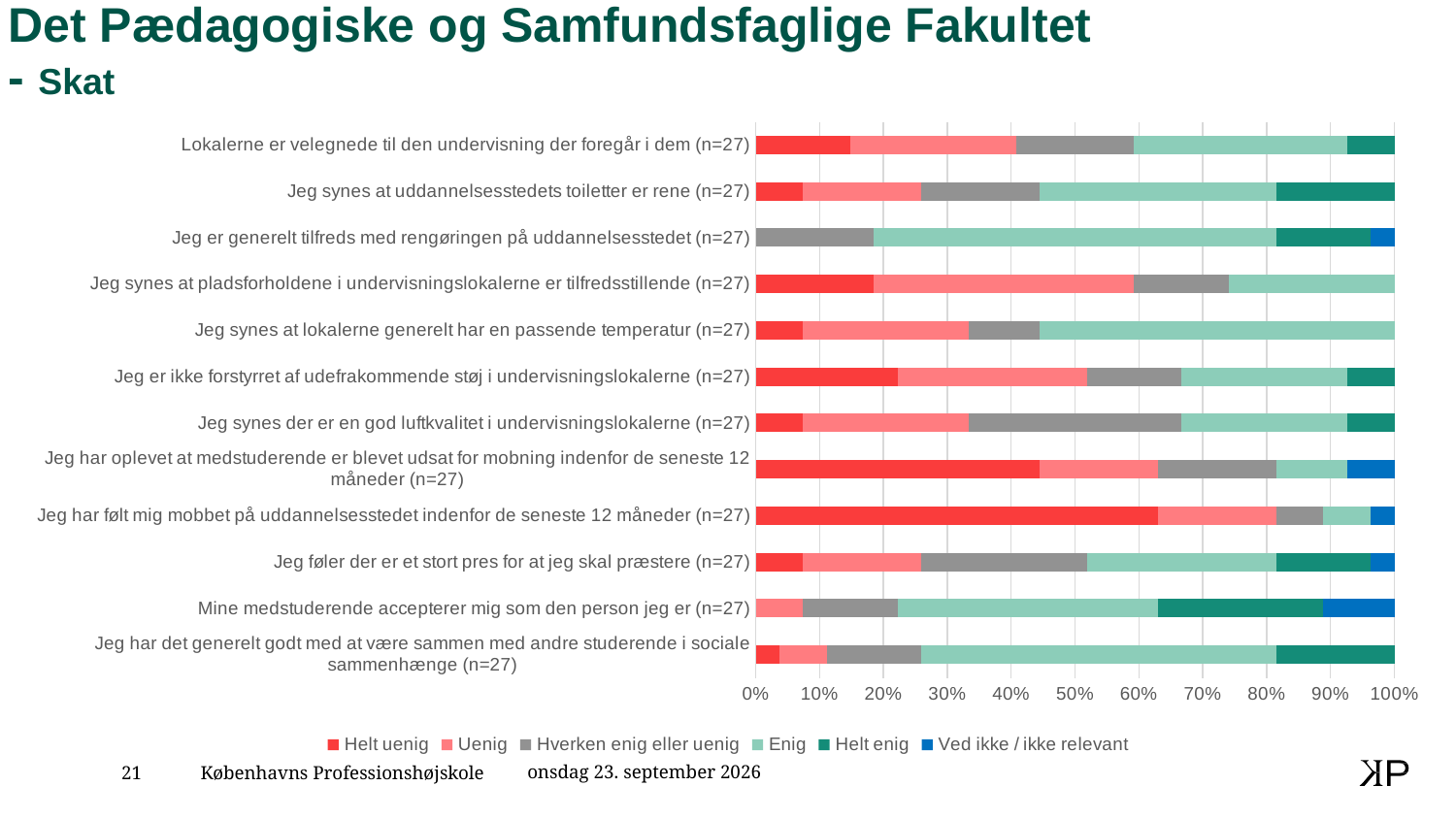
How many series does the legend list? 6 How many statements (categories) are plotted in the chart? 12 Which statement has the largest 'Helt uenig' share? Jeg har følt mig mobbet på uddannelsesstedet indenfor de seneste 12 måneder Which response category is shown in blue in the legend? Ved ikke / ikke relevant What kind of chart is shown on the slide? Stacked bar chart Which statement has the largest 'Ved ikke / ikke relevant' share? Mine medstuderende accepterer mig som den person jeg er Which has the larger 'Helt uenig' share: 'Lokalerne er velegnede til den undervisning der foregår i dem' or 'Jeg har følt mig mobbet på uddannelsesstedet indenfor de seneste 12 måneder'? Jeg har følt mig mobbet på uddannelsesstedet indenfor de seneste 12 måneder What does each stacked bar total on the x axis? 100% What is the sample size (n) shown for each statement? 27 Is the 'Helt uenig' share for 'Jeg har følt mig mobbet på uddannelsesstedet indenfor de seneste 12 måneder' greater or less than 50%? greater Is the 'Helt uenig' share for 'Jeg har oplevet at medstuderende er blevet udsat for mobning indenfor de seneste 12 måneder' greater or less than 50%? less Is the 'Enig' share for 'Jeg synes at lokalerne generelt har en passende temperatur' greater or less than 50%? greater